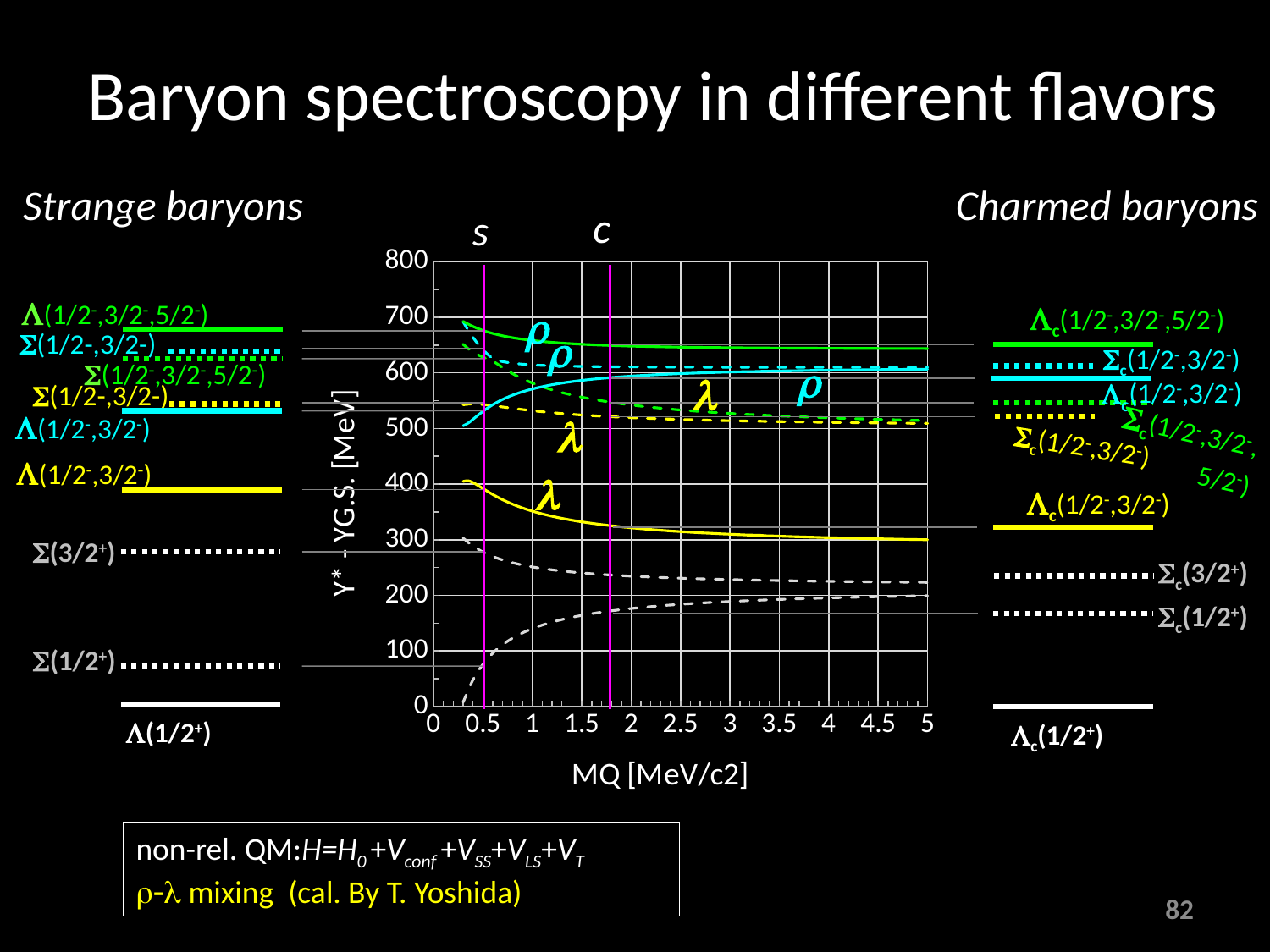
What is the title of the y axis of the chart? Y* - YG.S. [MeV] Is the value of the solid green curve at MQ = 5 greater or less than 500? greater Does the lowest white dashed curve rise or fall as MQ increases from 0.5 to 5? rise Is the value of the solid yellow λ curve at MQ = 5 greater or less than 400? less What is the highest value shown on the x axis of the chart? 5 What is the highest value shown on the y axis of the chart? 800 What kind of chart is shown in the centre of the slide? line chart What is the title of the x axis of the chart? MQ [MeV/c2] How many tick labels are shown along the x axis of the chart? 11 Is the value of the solid cyan curve at MQ = 5 greater or less than 500? greater How many vertical magenta lines are drawn on the chart? 2 Does the solid yellow λ curve rise or fall as MQ increases from 0.5 to 5? fall